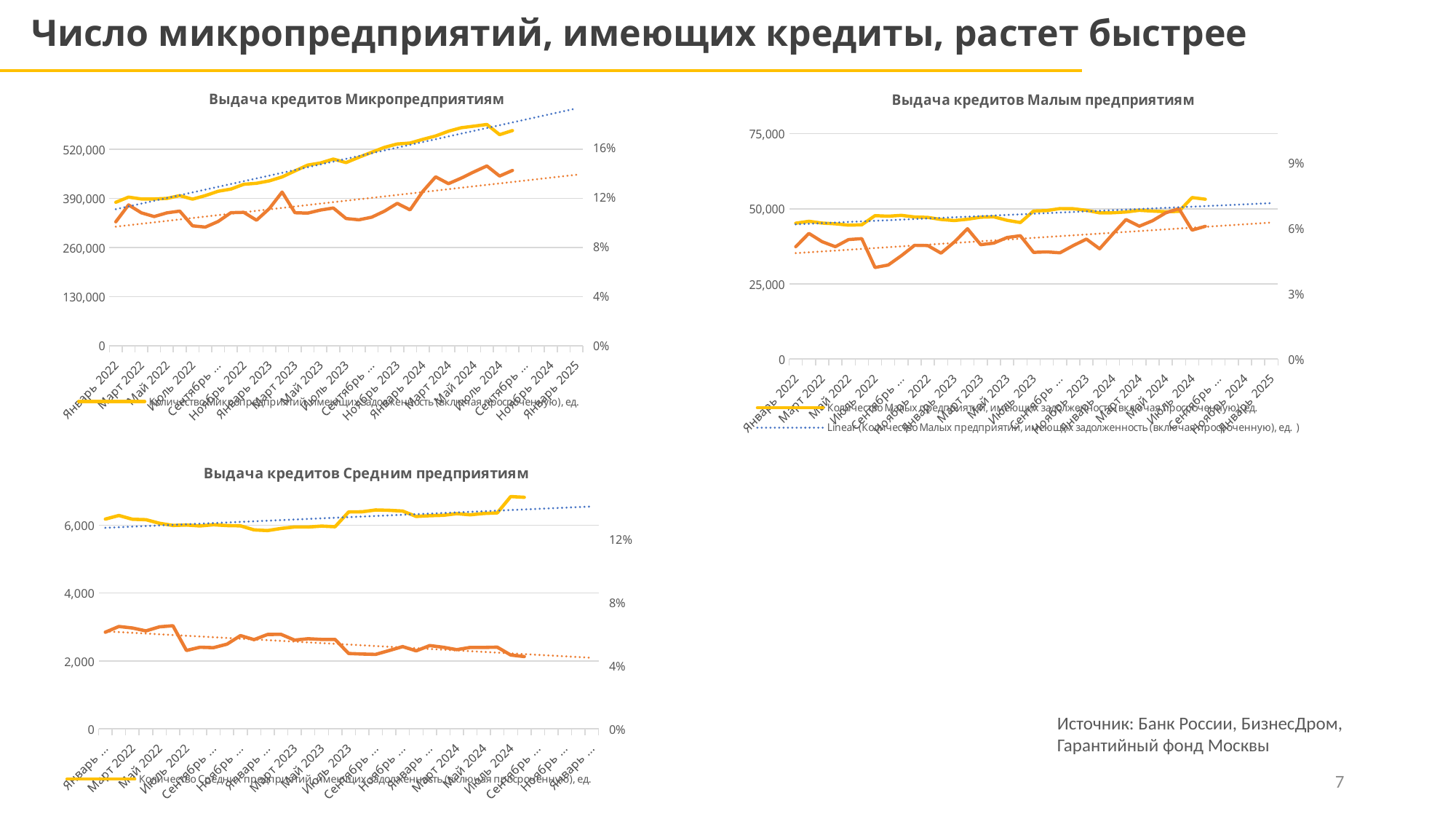
What is the title of the chart in the top right of the slide? Выдача кредитов Малым предприятиям What is the highest tick on the right-hand axis of the chart "Выдача кредитов Микропредприятиям"? 16% In the chart "Выдача кредитов Средним предприятиям", is the orange line's value at Январь 2022 greater or less than 8%? less How many charts are shown on the slide? 3 In the chart "Выдача кредитов Средним предприятиям", is the yellow line's value at Сентябрь 2024 greater or less than 6,000? greater In the chart "Выдача кредитов Малым предприятиям", is the yellow line's value at Январь 2022 greater or less than 50,000? less What kind of chart is "Выдача кредитов Микропредприятиям"? line chart In the chart "Выдача кредитов Средним предприятиям", does the orange line rise or fall from Январь 2022 to Сентябрь 2024? fall In the chart "Выдача кредитов Микропредприятиям", does the yellow line rise or fall from Январь 2022 to Сентябрь 2024? rise